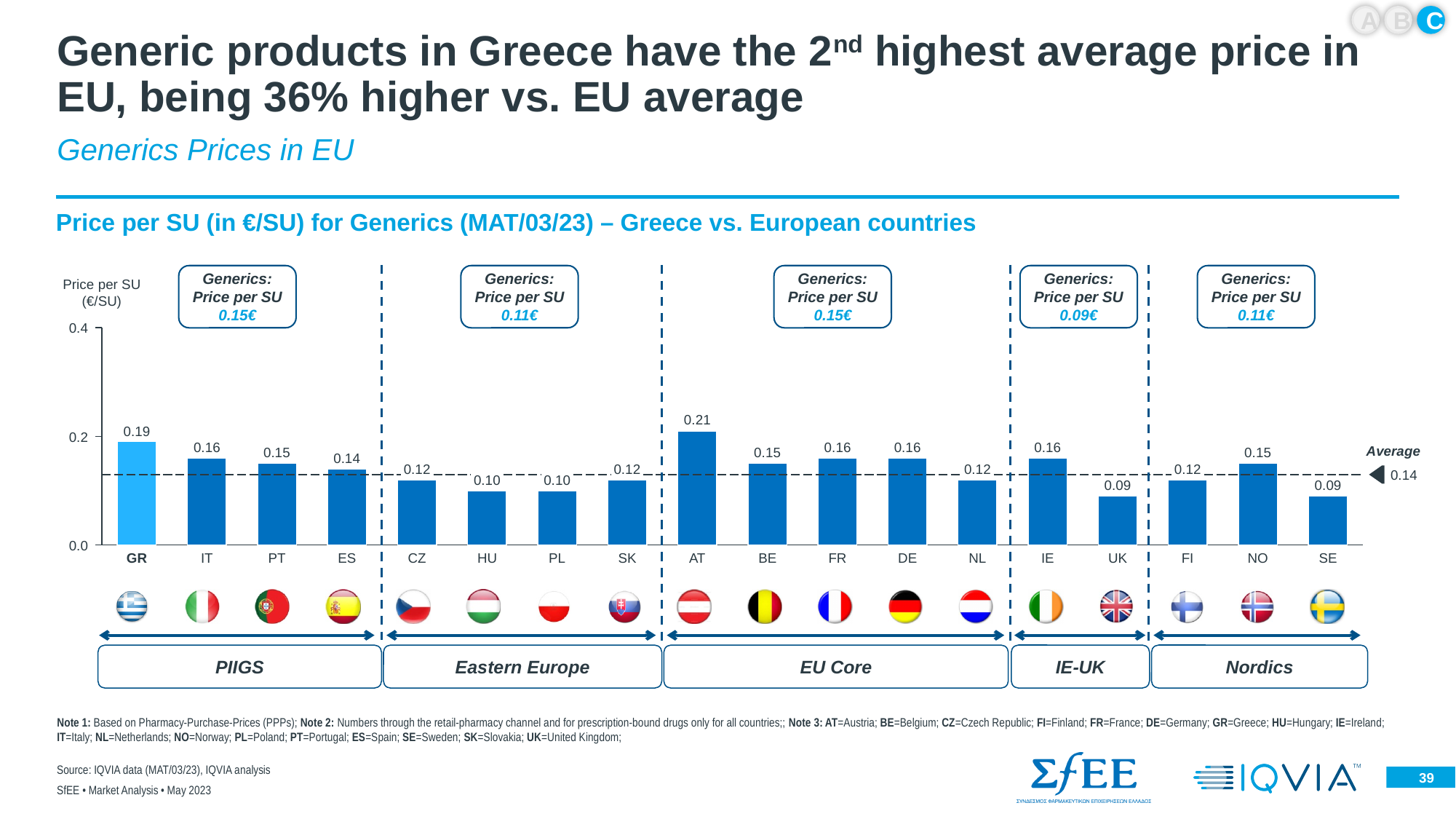
What kind of chart is used to show the price per SU by country? bar chart How many countries are shown on the chart? 18 What is the generics price per SU for the Eastern Europe group? 0.11€ What is the average price per SU shown by the dashed line? 0.14 What is the difference in price per SU between Greece (GR) and Italy (IT)? 0.03 Which has a higher price per SU for generics, Hungary (HU) or Slovakia (SK)? SK What is the price per SU for generics in Austria (AT)? 0.21 What is the price per SU for generics in Greece (GR)? 0.19 Is the price per SU for the UK greater or less than 0.2? less What is the generics price per SU for the IE-UK group? 0.09€ What is the difference in price per SU between Austria (AT) and the Netherlands (NL)? 0.09 Which country has the highest price per SU for generics? AT